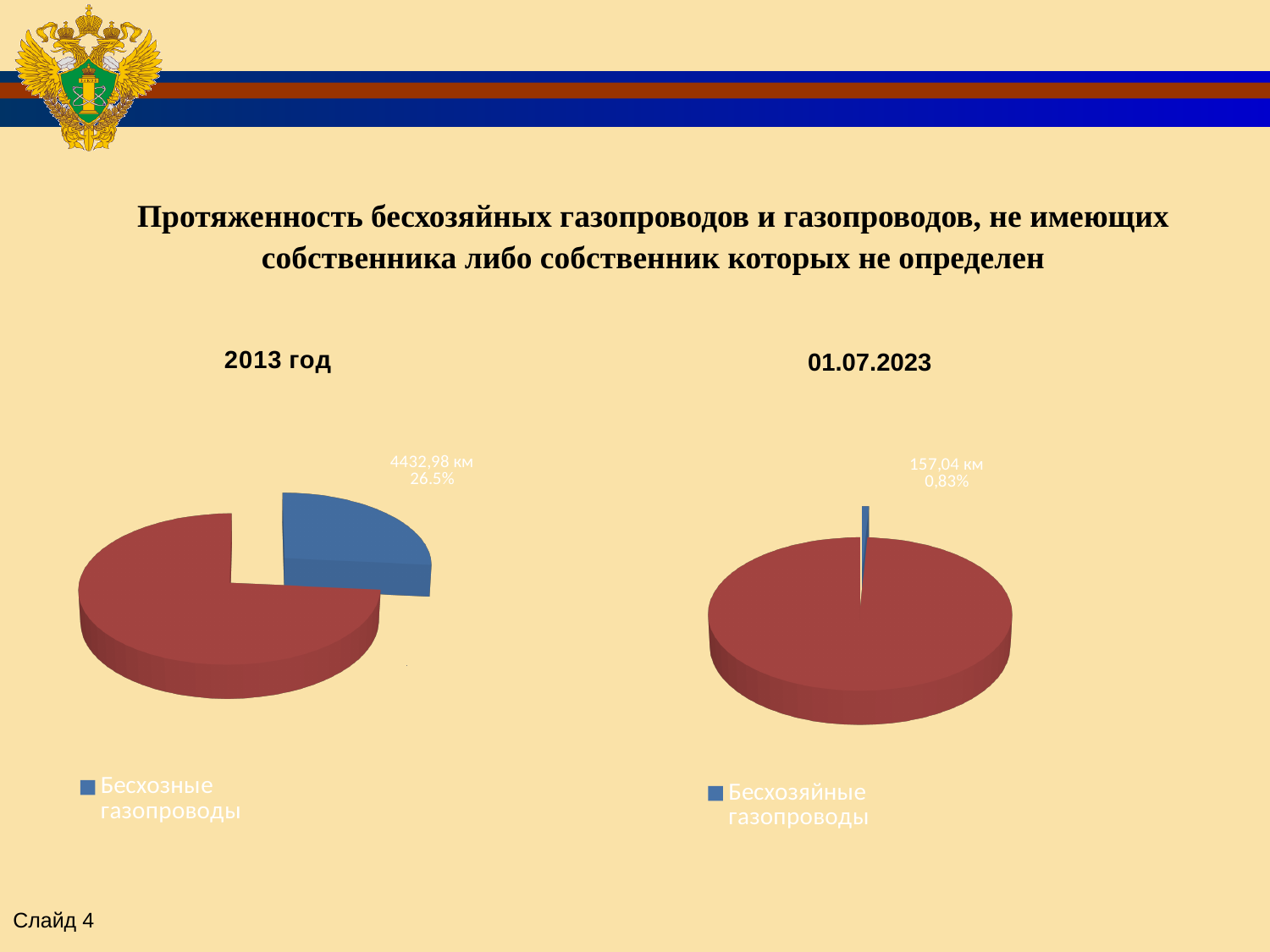
What is the legend entry shown under the "01.07.2023" chart? Бесхозяйные газопроводы What kind of chart is the one titled "01.07.2023"? pie chart Which chart shows the larger blue slice, "2013 год" or "01.07.2023"? 2013 год How many entries does the legend of the "2013 год" chart list? 1 In the "2013 год" chart, what share of the pie does the blue slice represent? 26.5% In the "2013 год" chart, what length is shown on the data label of the blue slice? 4432,98 км How many slices does the "01.07.2023" pie chart have? 2 In the "01.07.2023" chart, what share of the pie does the blue slice represent? 0,83% In the "2013 год" chart, which slice is larger, the red one or the blue one? the red one In the "01.07.2023" chart, what length is shown on the data label of the blue slice? 157,04 км What kind of chart is the one titled "2013 год"? pie chart What colour is the slice labelled "4432,98 км" in the "2013 год" chart? blue